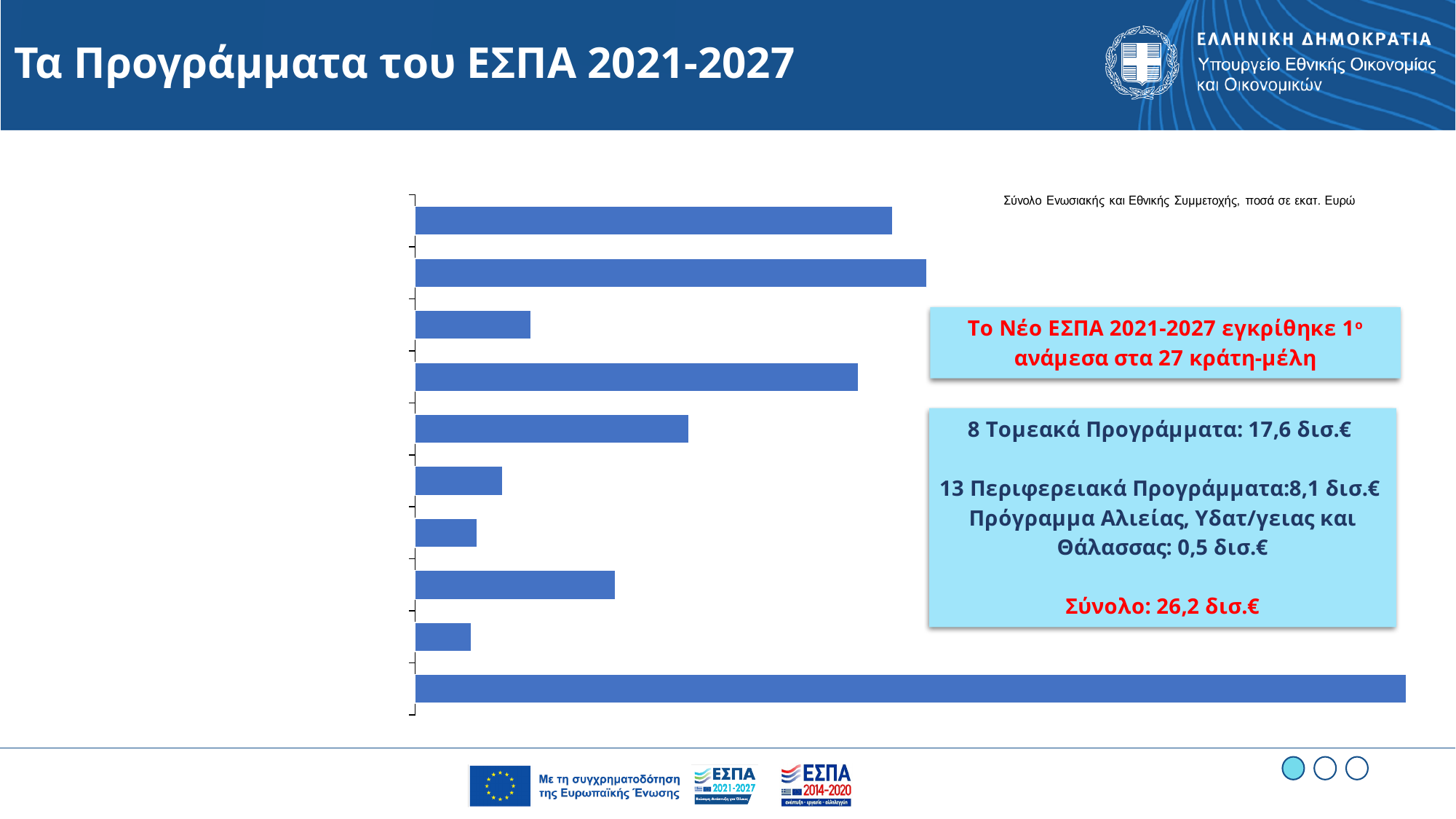
Which is longer, the third bar from the top or the fourth bar from the top? the fourth bar from the top Are the bars in the chart horizontal or vertical? horizontal According to the note above the chart, in what unit are the amounts expressed? εκατ. Ευρώ (million euros) Which is longer, the eighth bar from the top or the ninth bar from the top? the eighth bar from the top What kind of chart is shown on the slide? bar chart Which bar in the chart is the longest? the bottom (tenth) bar Which is longer, the sixth bar from the top or the seventh bar from the top? the sixth bar from the top How many bars does the chart contain? 10 Which bar in the chart is the shortest? the ninth bar from the top (second from the bottom)